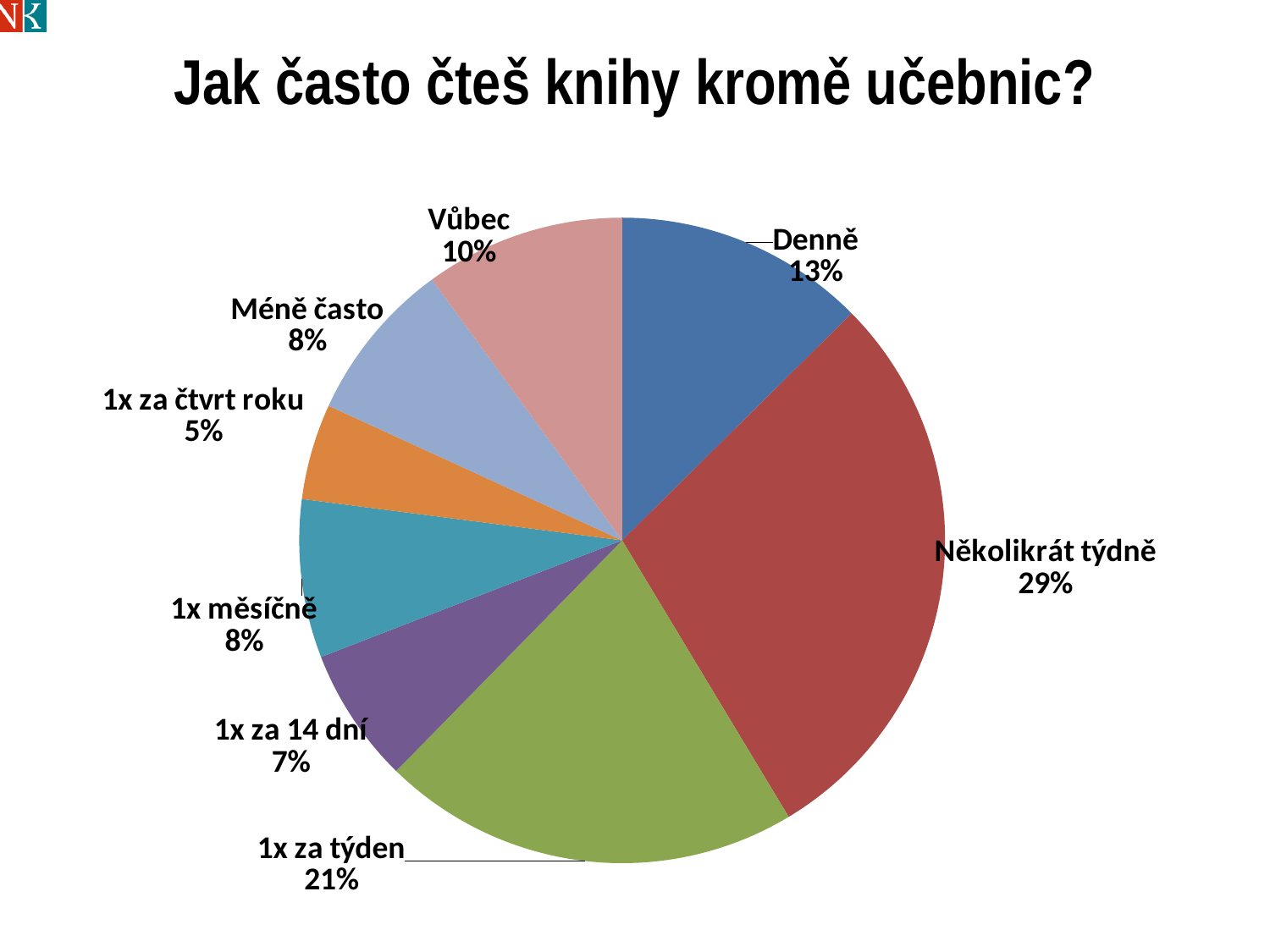
Which is larger, "Vůbec" or "1x za 14 dní"? Vůbec What is the title of the chart? Jak často čteš knihy kromě učebnic? What is the value for "1x za čtvrt roku"? 5% What is the value for "Denně"? 13% Which category has the largest slice? Několikrát týdně What is the value for "1x za týden"? 21% What is the difference between "Několikrát týdně" and "1x za týden"? 8% What share of the pie does "Několikrát týdně" have? 29% Which category has the smallest slice? 1x za čtvrt roku How many categories does the pie chart have? 8 What is the difference between "Denně" and "Vůbec"? 3% What kind of chart is shown on the slide? pie chart